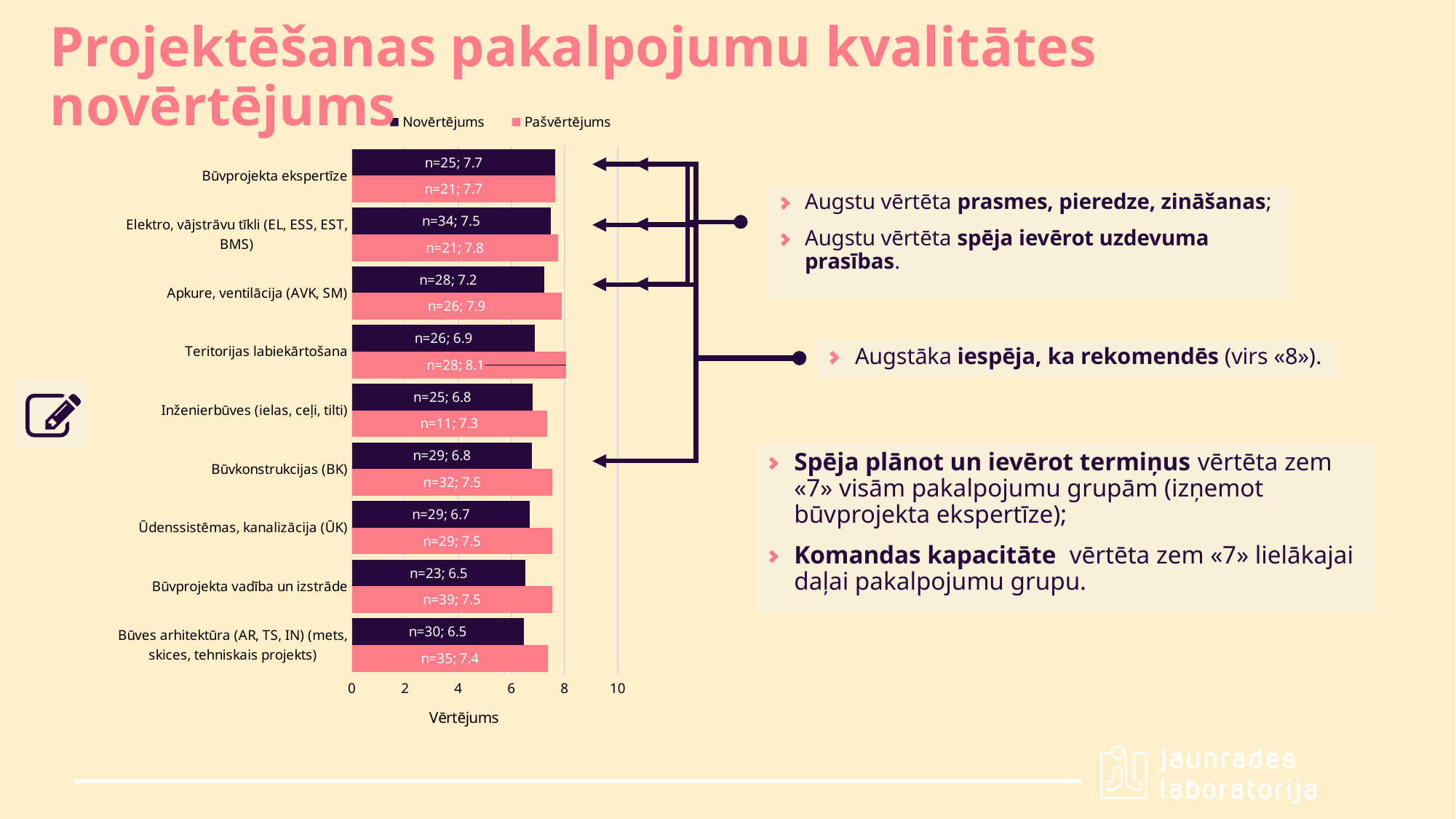
Is the Pašvērtējums value for Teritorijas labiekārtošana greater or less than 8? greater Which category has the highest Novērtējums value? Būvprojekta ekspertīze What is the n (sample size) shown for the Pašvērtējums bar of Būvprojekta vadība un izstrāde? n=39 Which category has the lowest Pašvērtējums value? Inženierbūves (ielas, ceļi, tilti) Which category has the highest Pašvērtējums value? Teritorijas labiekārtošana What kind of chart is shown on the slide? Bar chart For Apkure, ventilācija (AVK, SM), which is larger: the Novērtējums or the Pašvērtējums value? Pašvērtējums What is the Novērtējums value for Būvprojekta ekspertīze? 7.7 How many series does the chart legend list? 2 How many service categories are shown on the chart? 9 What is the difference between the Pašvērtējums and Novērtējums values for Teritorijas labiekārtošana? 1.2 What is the Pašvērtējums value for Teritorijas labiekārtošana? 8.1